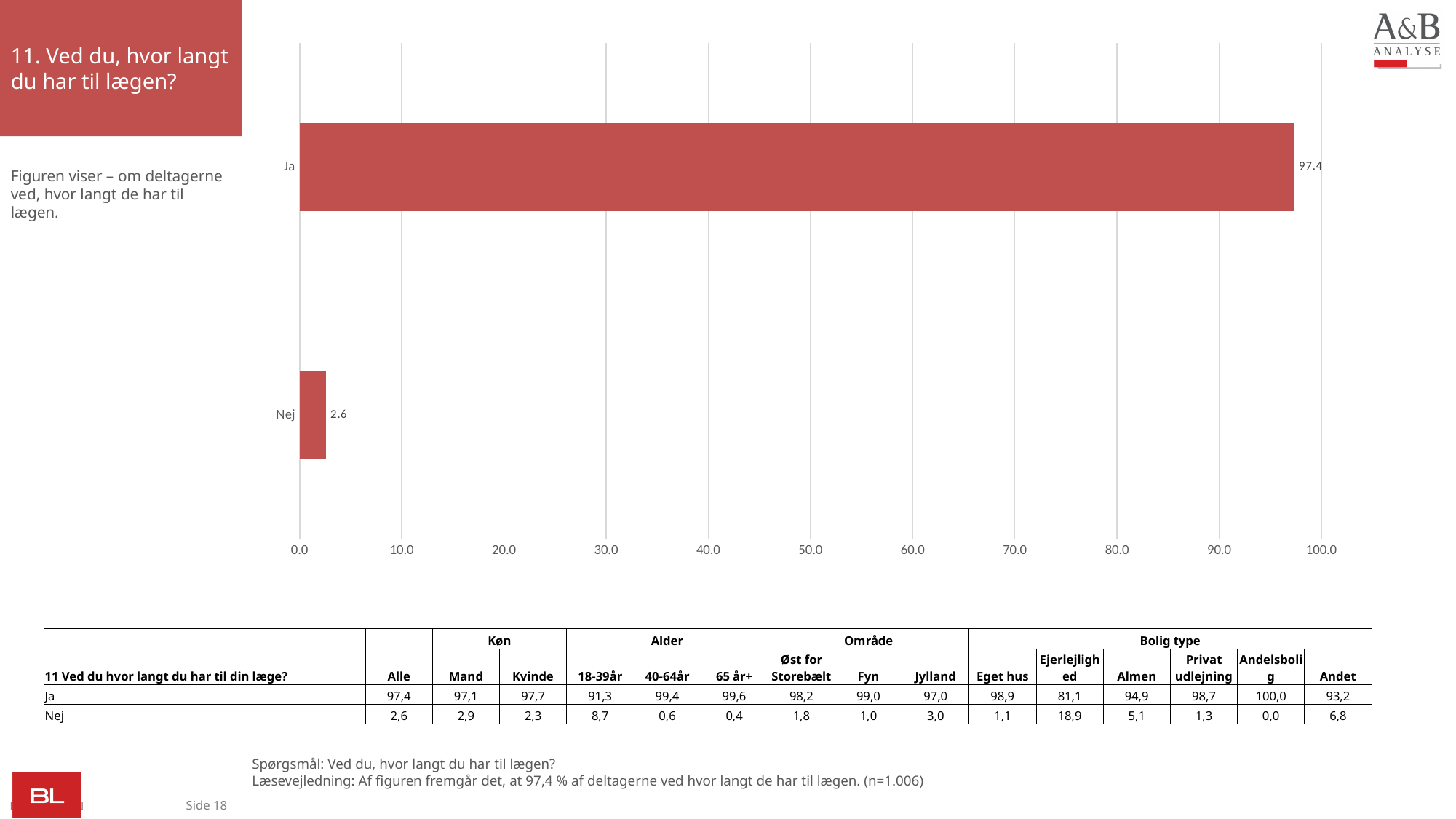
What colour are the bars in the chart? red Which category has the lowest value? Nej What is the value for "Ja"? 97.4 What is the maximum value shown on the x axis? 100.0 Which category has the highest value? Ja What is the value for "Nej"? 2.6 What is the difference between the values for "Ja" and "Nej"? 94.8 What kind of chart is shown on the slide? bar chart Which is larger, the value for "Ja" or the value for "Nej"? Ja How many categories are shown in the chart? 2 Is the value for "Nej" greater or less than 10.0? less Is the value for "Ja" greater or less than 90.0? greater